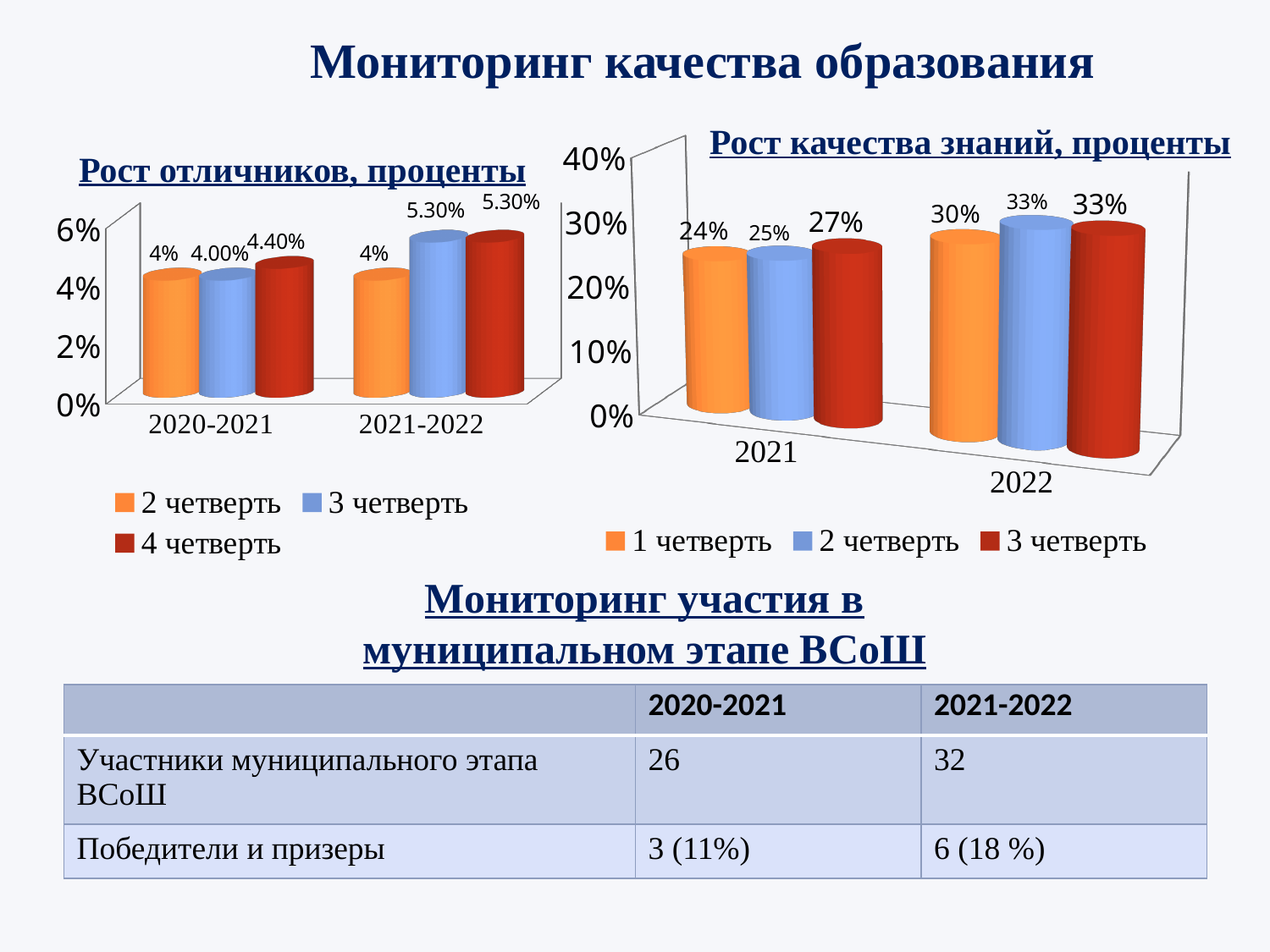
In the chart 'Рост качества знаний, проценты', which category has the lowest value for 1 четверть? 2021 In the chart 'Рост отличников, проценты', what is the difference between 3 четверть in 2021-2022 and 3 четверть in 2020-2021? 1.30% In the chart 'Рост качества знаний, проценты', what is the value for 1 четверть in 2021? 24% In the chart 'Рост качества знаний, проценты', is the value for 2 четверть in 2022 larger or smaller than the value for 2 четверть in 2021? larger In the chart 'Рост качества знаний, проценты', what is the value for 3 четверть in 2022? 33% In the chart 'Рост качества знаний, проценты', how many categories are shown on the x axis? 2 In the chart 'Рост качества знаний, проценты', what is the difference between 1 четверть in 2022 and 1 четверть in 2021? 6% In the chart 'Рост отличников, проценты', what is the value for 2 четверть in 2021-2022? 4% In the chart 'Рост отличников, проценты', what is the value for 4 четверть in 2021-2022? 5.30% In the chart 'Рост отличников, проценты', how many series does the legend list? 3 In the chart 'Рост отличников, проценты', what is the value for 4 четверть in 2020-2021? 4.40% What kind of chart is 'Рост качества знаний, проценты'? bar chart